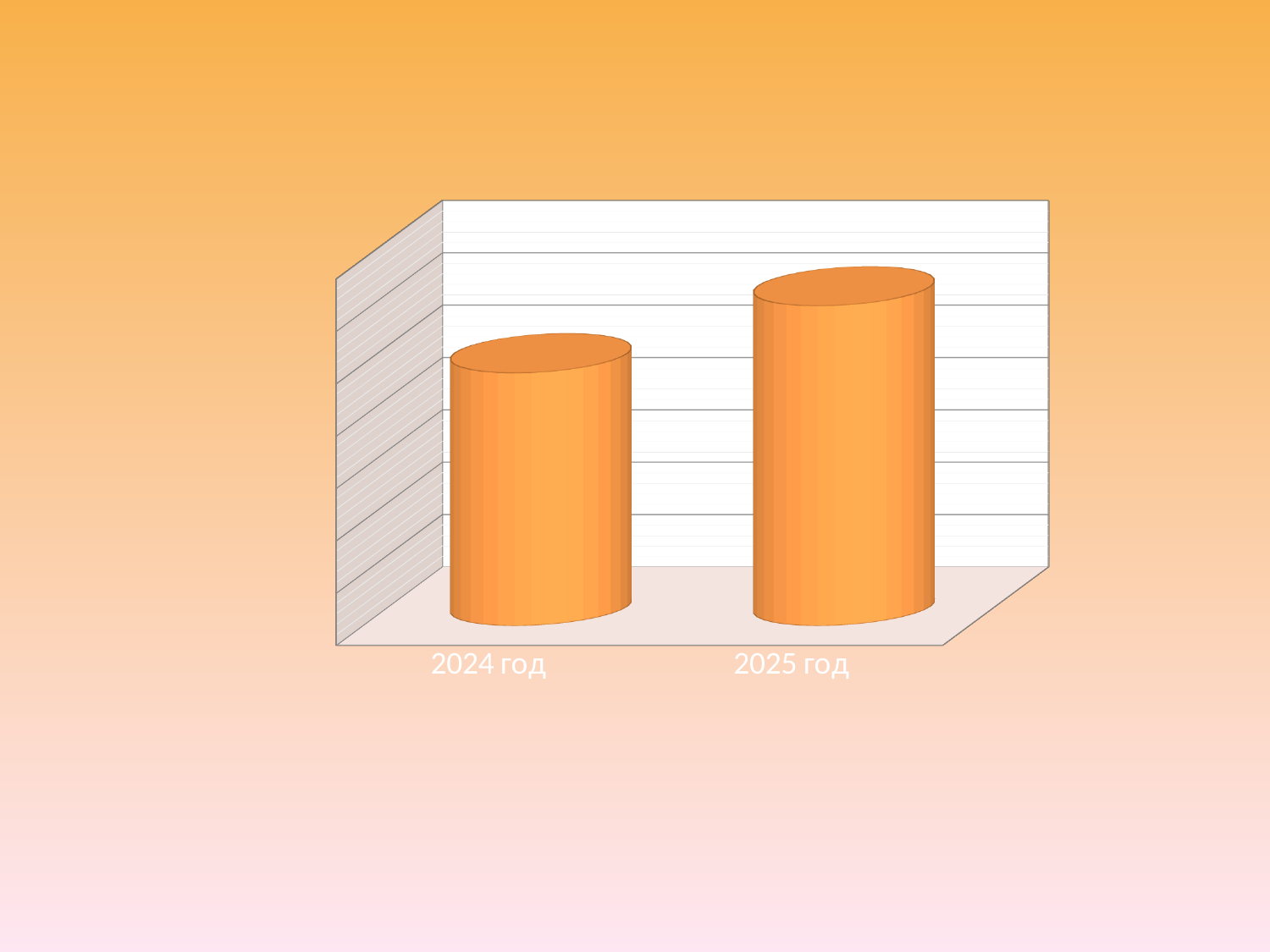
Which is larger, the value for 2024 год or the value for 2025 год? 2025 год What are the category labels shown on the x axis of the chart? 2024 год, 2025 год What colour are the bars on the chart? orange Which category has the lowest value on the chart? 2024 год Do the values rise or fall from 2024 год to 2025 год? rise Which category has the highest value on the chart? 2025 год What kind of chart is shown on the slide? bar chart How many categories are plotted on the chart? 2